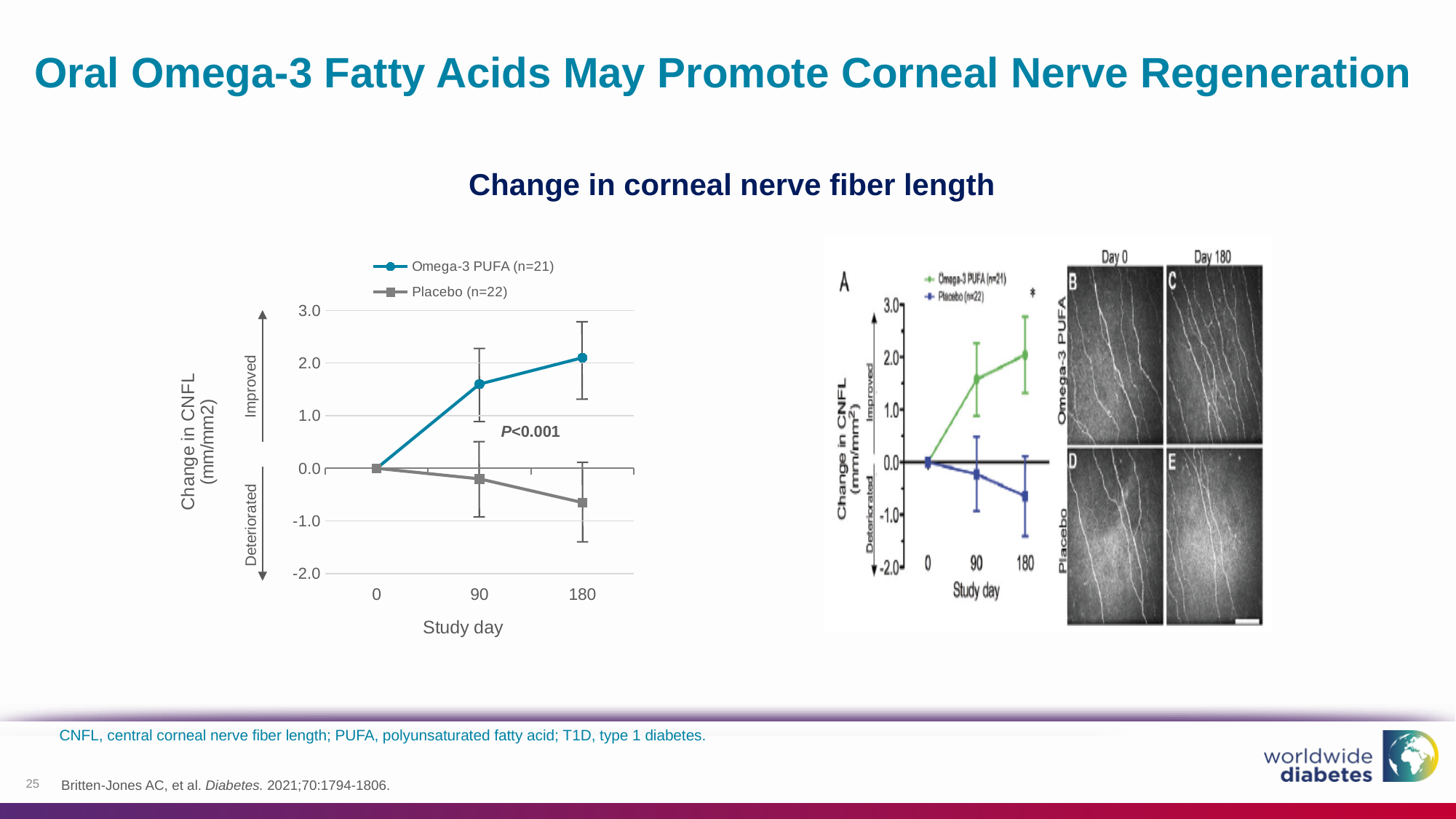
In the line chart on the left, is the value for Omega-3 PUFA at day 90 greater or less than 1.0? greater In the line chart on the left, does the Omega-3 PUFA line rise or fall from day 0 to day 180? Rises In the line chart on the left, is the value for Placebo at day 180 greater or less than 0.0? less In the line chart on the left, what is the change in CNFL for Placebo at study day 0? 0.0 What is the title of the chart on the slide? Change in corneal nerve fiber length What type of chart is shown on the left of the slide? Line chart In the line chart on the left, what is the change in CNFL for Omega-3 PUFA at study day 0? 0.0 In the line chart on the left, does the Placebo line rise or fall from day 0 to day 180? Falls In the line chart on the left, how many series does the legend list? 2 In the line chart on the left, how many study-day time points are plotted on the x axis? 3 In the line chart on the left, what P value is printed between the two lines? P<0.001 In the line chart on the left, which series has the higher change in CNFL at study day 180, Omega-3 PUFA or Placebo? Omega-3 PUFA